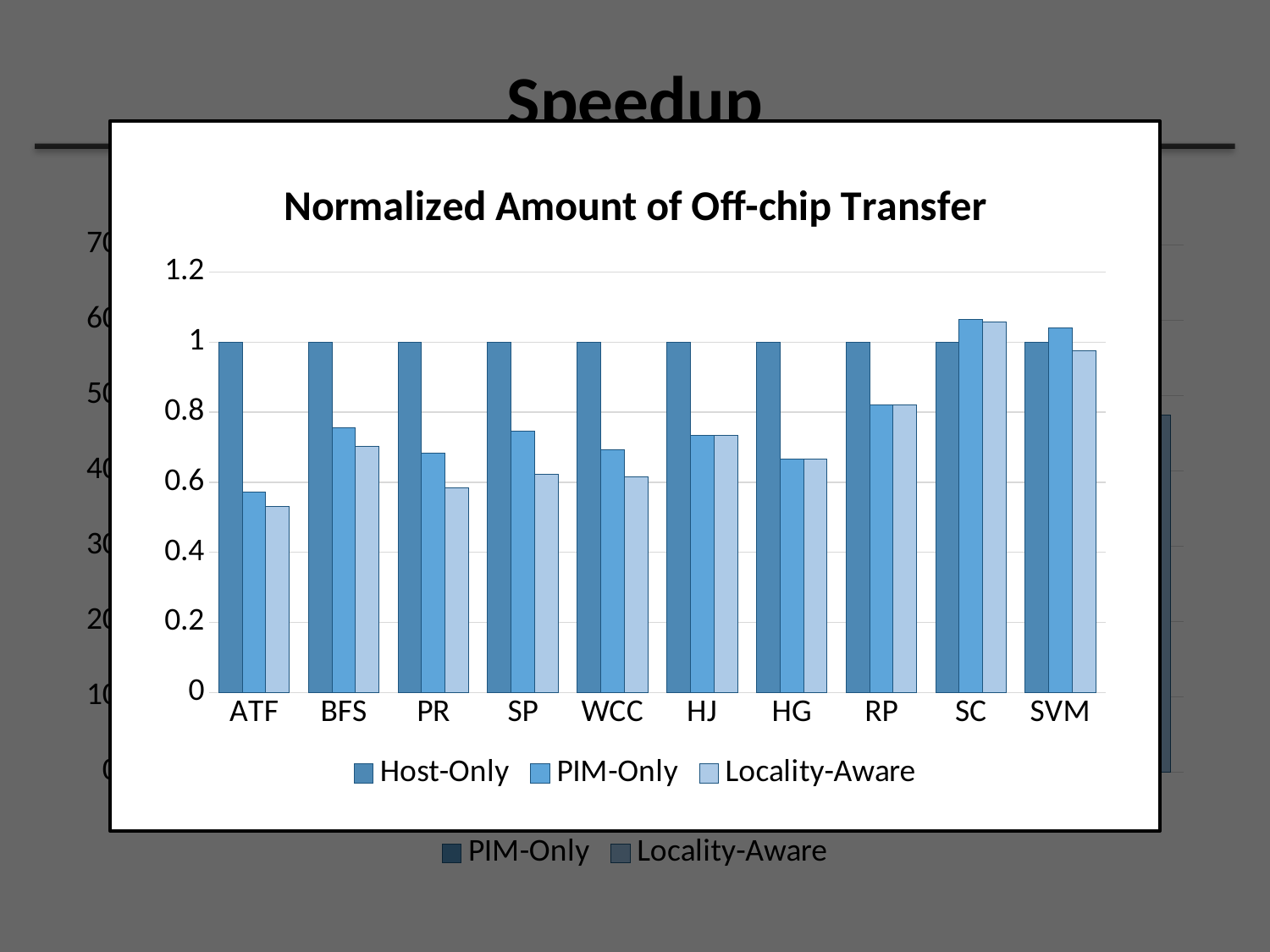
In the 'Normalized Amount of Off-chip Transfer' chart, is the Locality-Aware value for RP greater or less than 0.6? greater In the 'Normalized Amount of Off-chip Transfer' chart, which series are listed in the legend? Host-Only, PIM-Only, Locality-Aware In the 'Normalized Amount of Off-chip Transfer' chart, what is the Host-Only value for HG? 1 In the 'Normalized Amount of Off-chip Transfer' chart, what is the Host-Only value for BFS? 1 In the 'Normalized Amount of Off-chip Transfer' chart, which category has the lowest Locality-Aware value? ATF In the 'Normalized Amount of Off-chip Transfer' chart, is the PIM-Only value for SC greater or less than 1? greater In the 'Normalized Amount of Off-chip Transfer' chart, for BFS, which is larger: the PIM-Only value or the Locality-Aware value? PIM-Only In the 'Normalized Amount of Off-chip Transfer' chart, how many series does the legend list? 3 In the 'Normalized Amount of Off-chip Transfer' chart, is the Locality-Aware value for ATF greater or less than 0.6? less In the 'Normalized Amount of Off-chip Transfer' chart, what kind of chart is shown? bar chart In the 'Normalized Amount of Off-chip Transfer' chart, how many categories are shown on the x axis? 10